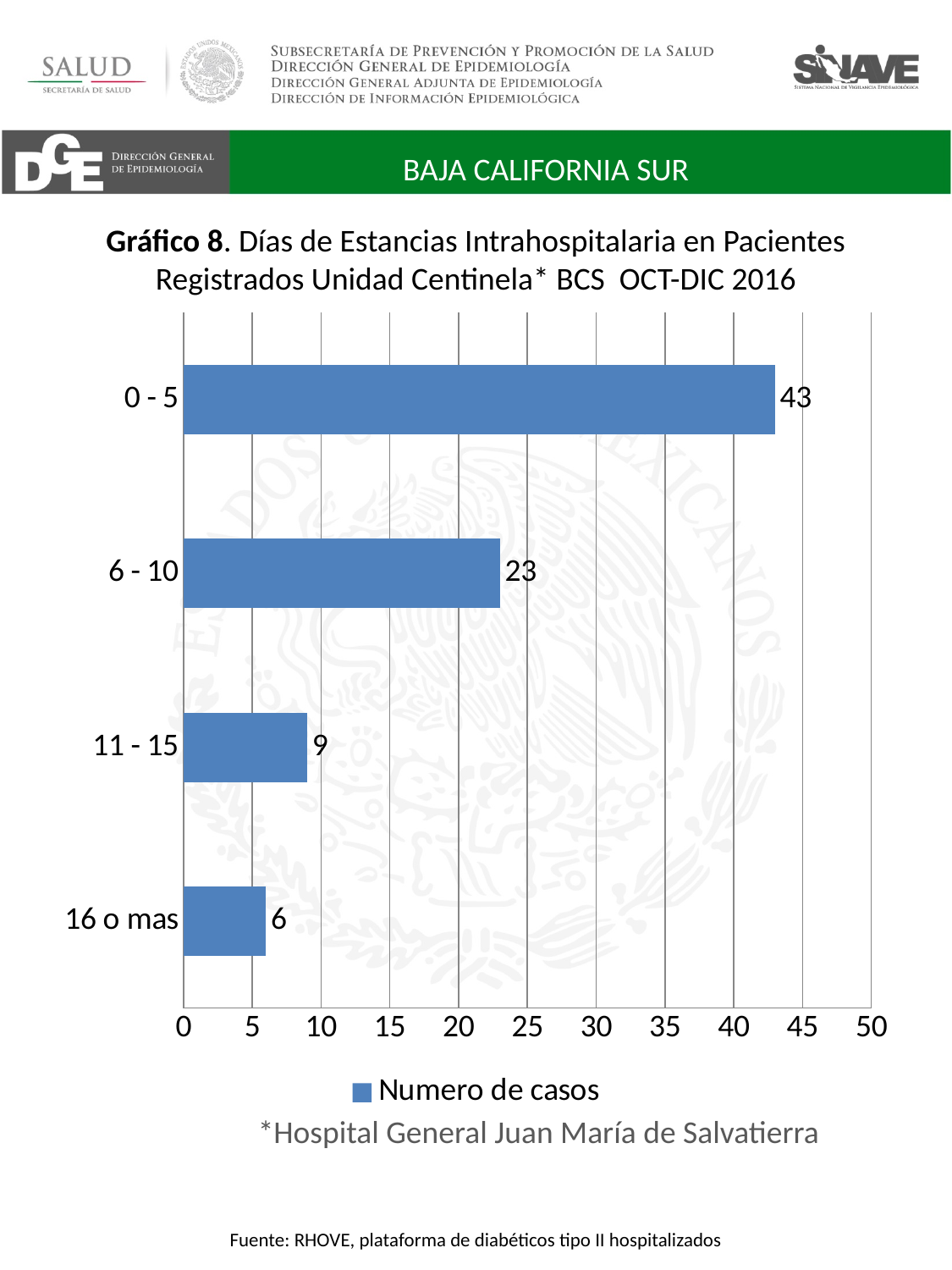
What is the number of cases for the 6 - 10 days category? 23 What kind of chart is shown on the slide? Bar chart What is the difference in number of cases between the 0 - 5 and 6 - 10 categories? 20 What is the number of cases for the 16 o mas category? 6 Which category has the highest number of cases? 0 - 5 Which has more cases, the 11 - 15 category or the 16 o mas category? 11 - 15 What is the number of cases for the 0 - 5 days category? 43 What is the number of cases for the 11 - 15 days category? 9 Which category has the lowest number of cases? 16 o mas How many categories of days of hospital stay are shown in the chart? 4 What is the name of the series shown in the legend? Numero de casos How many series does the legend list? 1